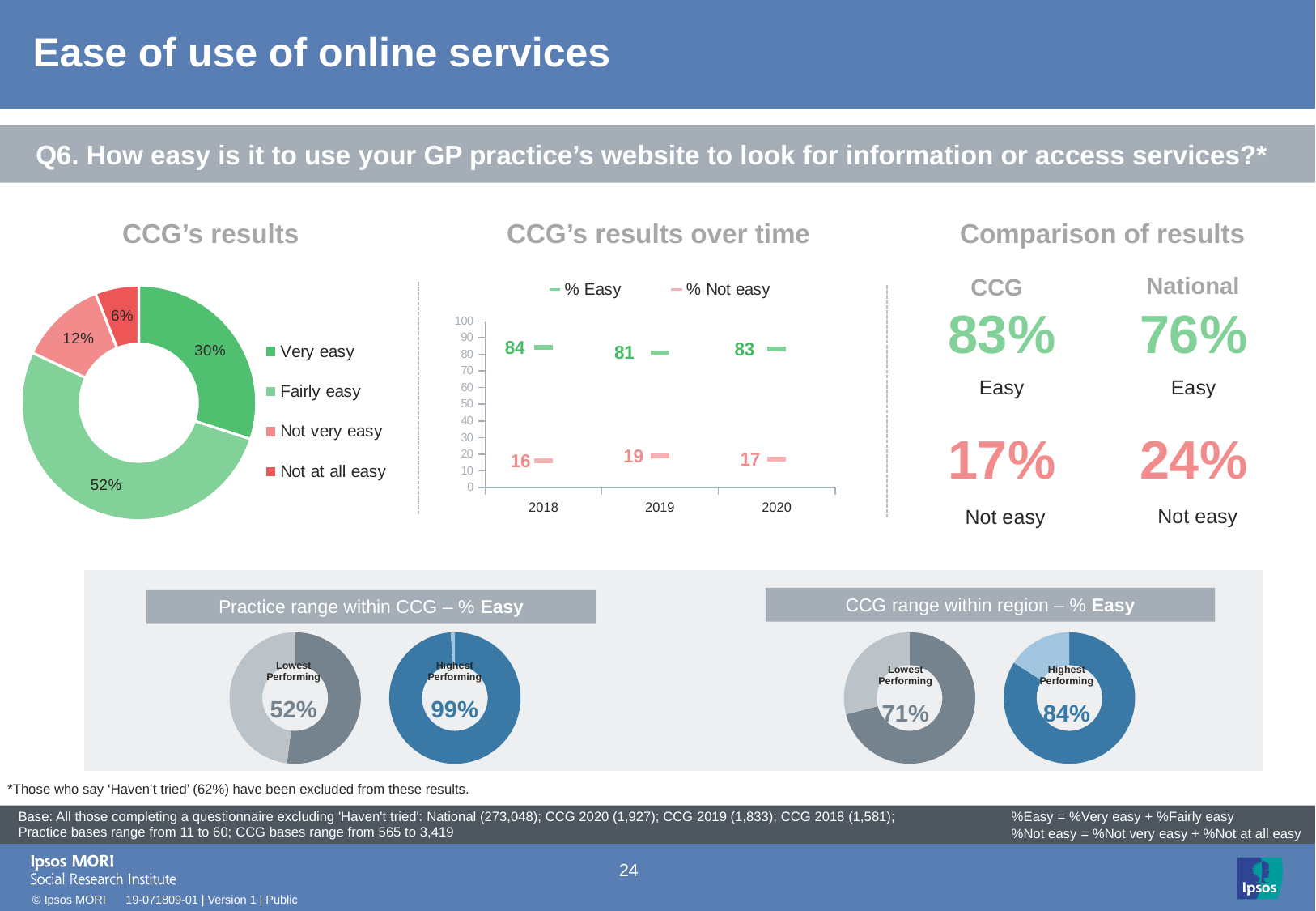
In the 'CCG's results over time' chart, which year has the highest % Easy value? 2018 In the 'CCG's results over time' chart, is the % Easy value for 2020 greater or less than 80? greater In the 'CCG's results over time' chart, what is the % Not easy value for 2018? 16 In the 'CCG's results' donut chart, which category has the largest share? Fairly easy How many series does the legend of the 'CCG's results over time' chart list? 2 In the 'CCG range within region – % Easy' section, what is the difference between the Highest Performing and Lowest Performing values? 13% In the 'Practice range within CCG – % Easy' section, what is the Highest Performing value? 99% In the 'CCG's results' donut chart, what is the difference between the 'Very easy' and 'Not very easy' shares? 18% In the 'CCG's results' donut chart, what percentage said 'Fairly easy'? 52% In the 'CCG's results' donut chart, which category has the smallest share? Not at all easy How many categories does the legend of the 'CCG's results' donut chart list? 4 In the 'CCG's results over time' chart, what is the % Easy value for 2019? 81